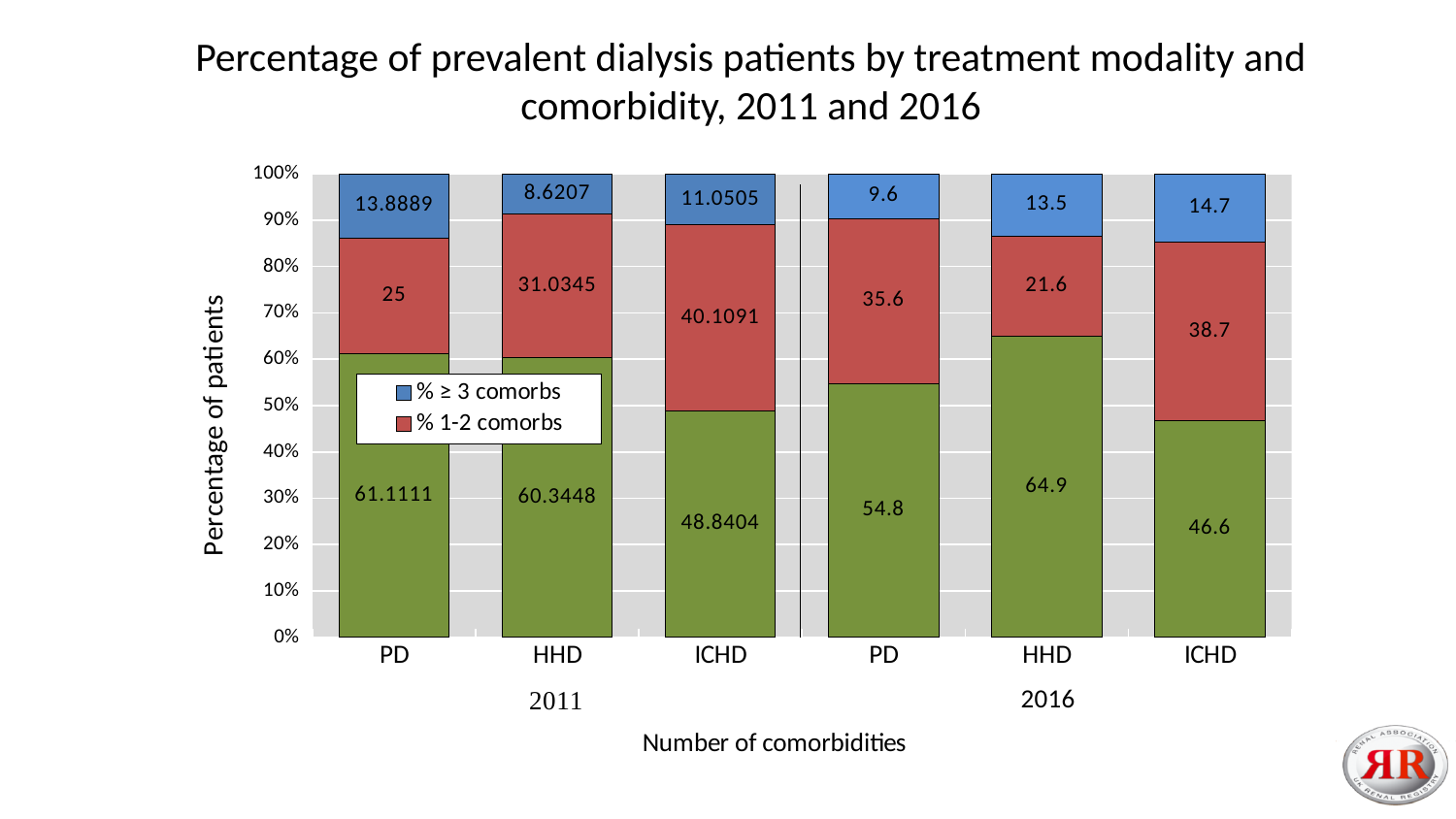
What type of chart is shown on the slide? Stacked bar chart What is the difference between the % ≥ 3 comorbs values for PD and HHD in 2011? 5.2682 What is the % 1-2 comorbs value for HHD in 2011? 31.0345 Which treatment modality had the highest % 1-2 comorbs in 2011? ICHD How many series does the legend list? 2 What is the % 1-2 comorbs value for ICHD in 2011? 40.1091 Is the % ≥ 3 comorbs value for ICHD larger in 2011 or in 2016? 2016 What is the % ≥ 3 comorbs value for HHD in 2016? 13.5 Which treatment modality had the highest % 1-2 comorbs in 2016? ICHD How many stacked bars are shown in the chart? 6 How much higher is the % 1-2 comorbs value for PD in 2016 than for PD in 2011? 10.6 Which treatment modality had the lowest % ≥ 3 comorbs in 2011? HHD